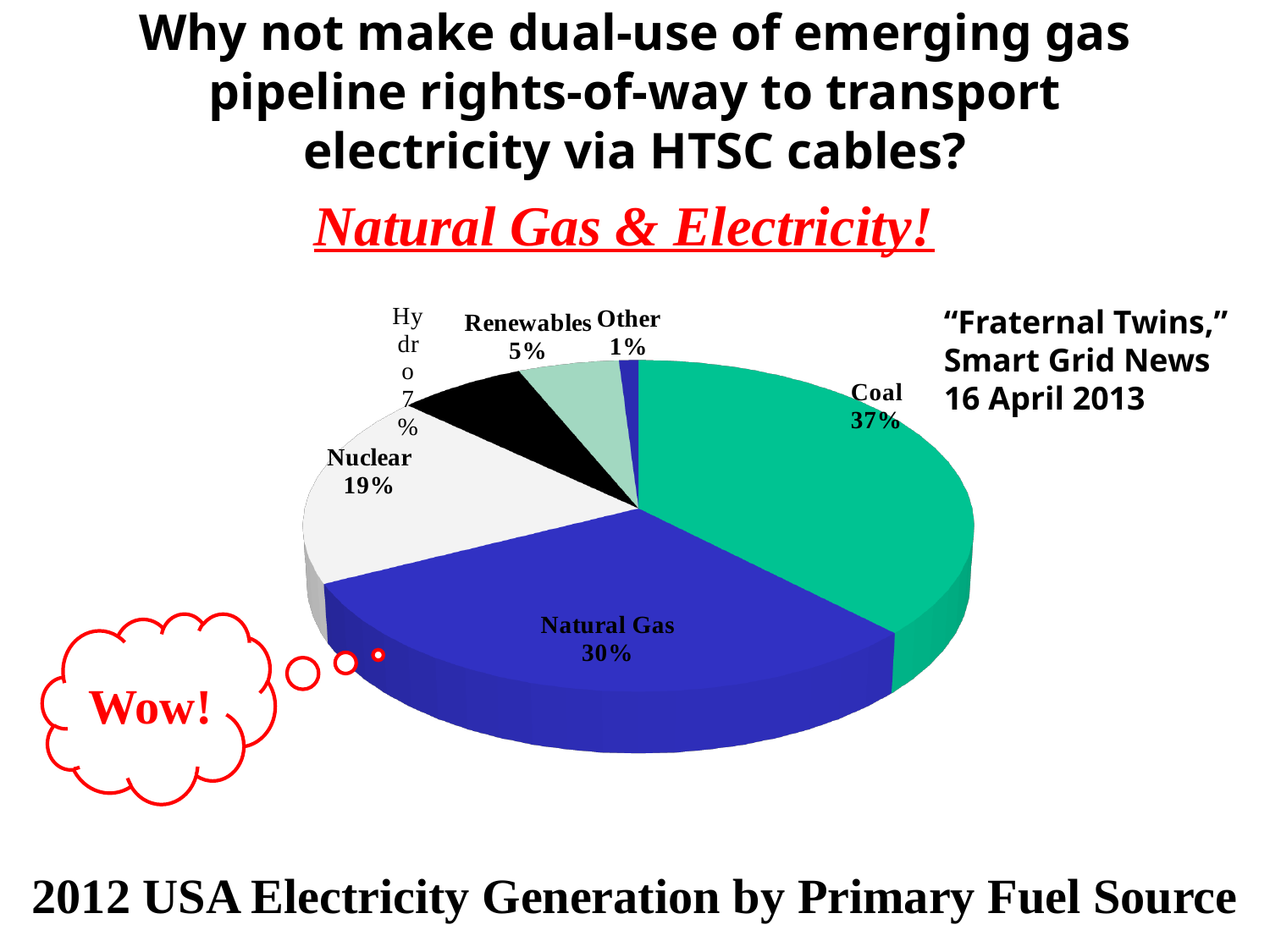
Which fuel source has the smallest slice of the pie? Other Which is larger, the Nuclear slice or the Hydro slice? Nuclear What type of chart is shown on the slide? Pie chart What is the difference in percentage points between Coal and Natural Gas? 7 What is the combined share of Natural Gas and Coal? 67% Which fuel source has the largest slice of the pie? Coal What percentage does the Renewables slice show? 5% How many fuel source categories are shown in the pie chart? 6 What is the title of the chart shown at the bottom of the slide? 2012 USA Electricity Generation by Primary Fuel Source What percentage is shown for Natural Gas? 30% What is the value labelled for Nuclear? 19% What share of the pie does Coal have? 37%